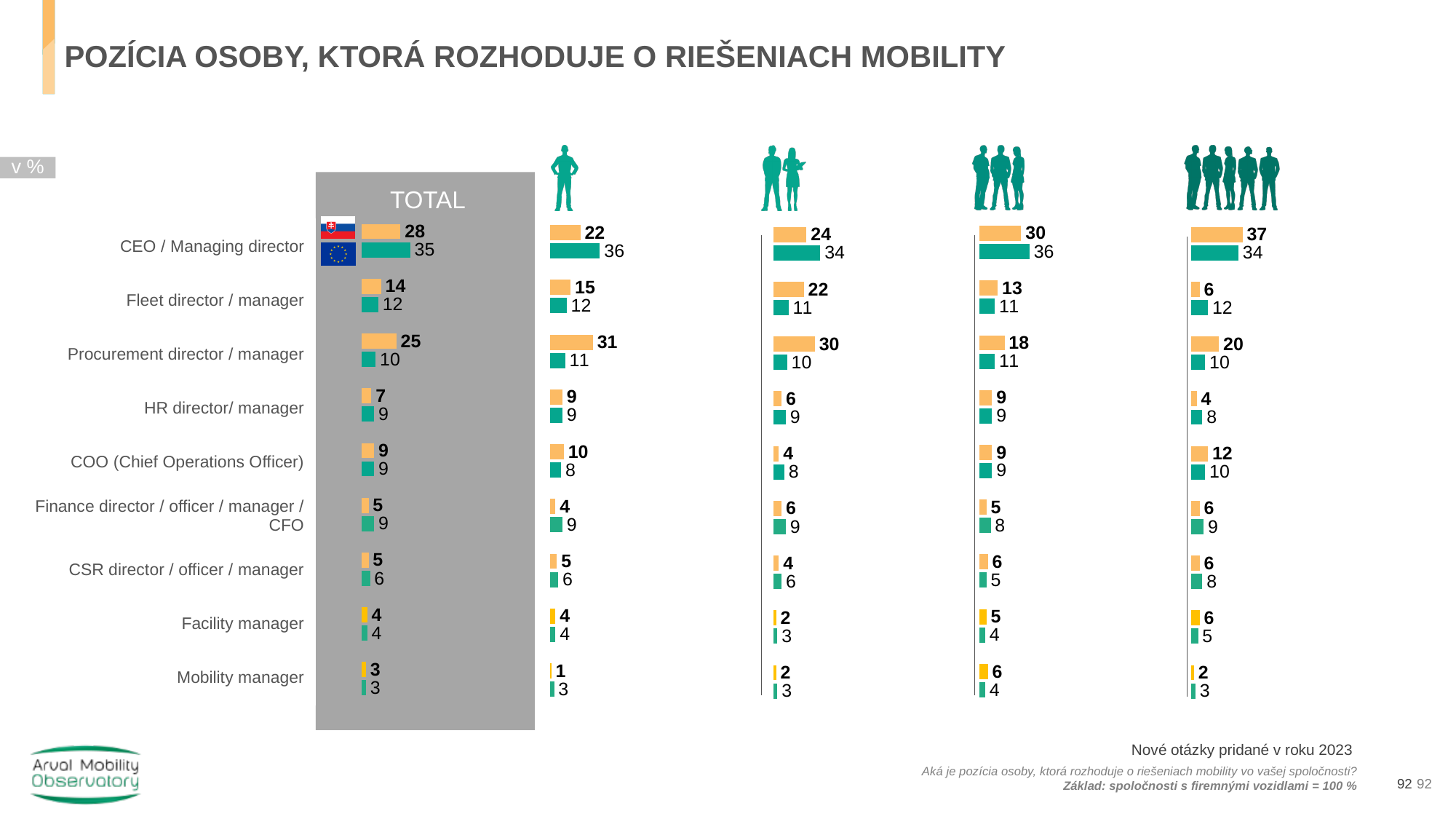
In the chart with the two-person icon, what is the green value for CEO / Managing director? 34 In the chart with the three-person icon, what is the orange value for Mobility manager? 6 In the TOTAL chart, which category has the highest orange (Slovak flag) value? CEO / Managing director In the chart with the single-person icon (first to the right of TOTAL), what is the orange value for Procurement director / manager? 31 What kind of chart is used on this slide? bar chart In the TOTAL chart, which category has the lowest green (EU flag) value? Mobility manager How many position categories are listed on the slide? 9 In the TOTAL chart, what is the difference between the green (EU flag) and orange (Slovak flag) values for CEO / Managing director? 7 In the TOTAL chart, which is larger for Fleet director / manager: the orange (Slovak flag) value or the green (EU flag) value? orange (Slovak flag), 14 In the TOTAL chart, what is the green (EU flag) value for Procurement director / manager? 10 In the TOTAL chart, what is the orange (Slovak flag) value for CEO / Managing director? 28 In the rightmost chart (largest group icon), what is the orange value for CEO / Managing director? 37